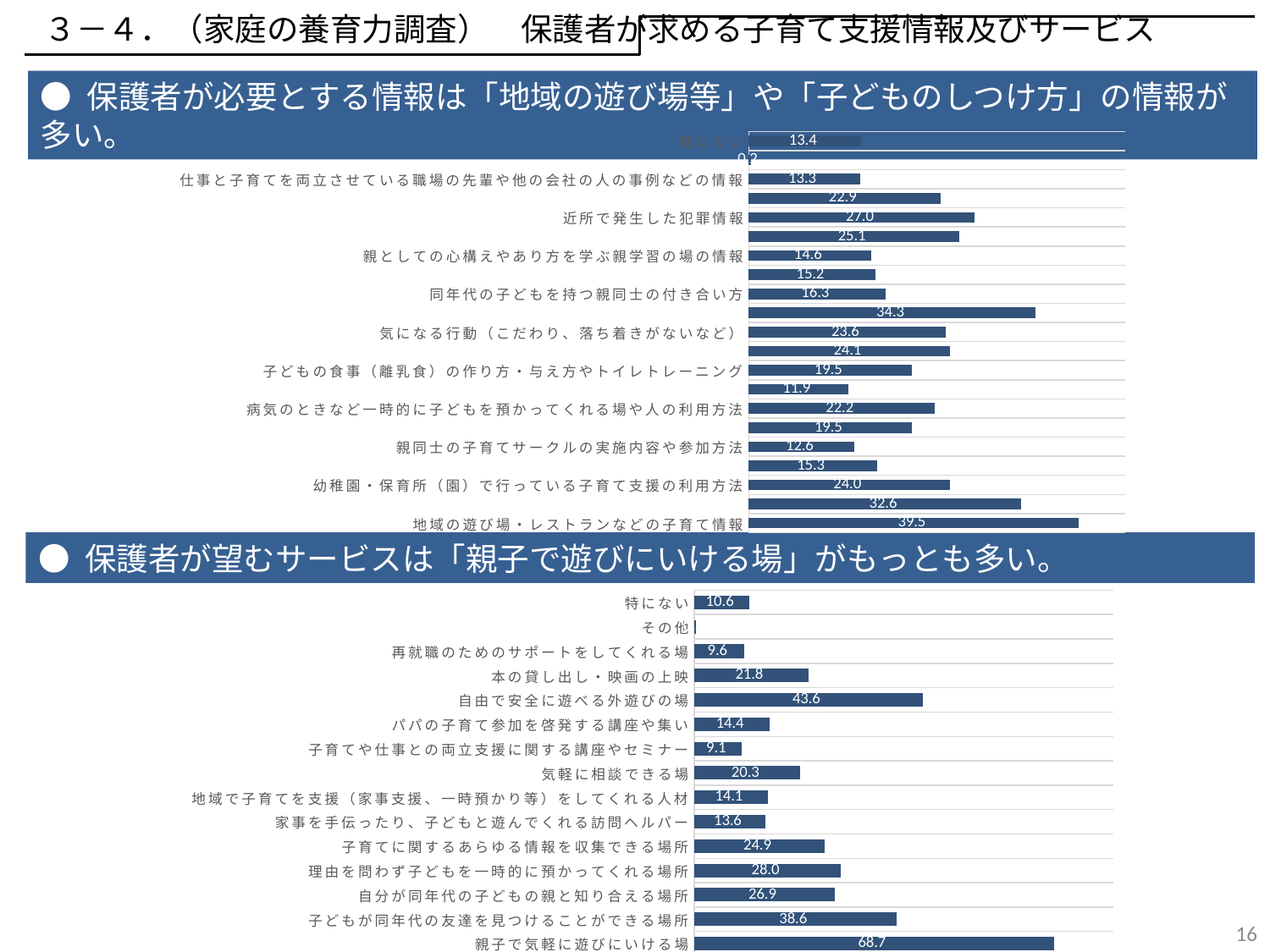
In the bottom chart, what is the value for 自由で安全に遊べる外遊びの場? 43.6 In the top chart, which is larger: 気になる行動（こだわり、落ち着きがないなど） or 親同士の子育てサークルの実施内容や参加方法? 気になる行動（こだわり、落ち着きがないなど） In the bottom chart, which is larger: 理由を問わず子どもを一時的に預かってくれる場所 or 自分が同年代の子どもの親と知り合える場所? 理由を問わず子どもを一時的に預かってくれる場所 In the bottom chart, how many categories are shown? 15 In the top chart, what is the value for 地域の遊び場・レストランなどの子育て情報? 39.5 In the bottom chart, which category has the highest value? 親子で気軽に遊びにいける場 What type of chart is the bottom chart? Bar chart In the top chart, what is the value for 近所で発生した犯罪情報? 27.0 In the bottom chart, what is the value for 親子で気軽に遊びにいける場? 68.7 In the bottom chart, what is the value for 気軽に相談できる場? 20.3 In the bottom chart, what is the difference between 親子で気軽に遊びにいける場 and 子どもが同年代の友達を見つけることができる場所? 30.1 In the top chart, what is the difference between 幼稚園・保育所（園）で行っている子育て支援の利用方法 and 仕事と子育てを両立させている職場の先輩や他の会社の人の事例などの情報? 10.7